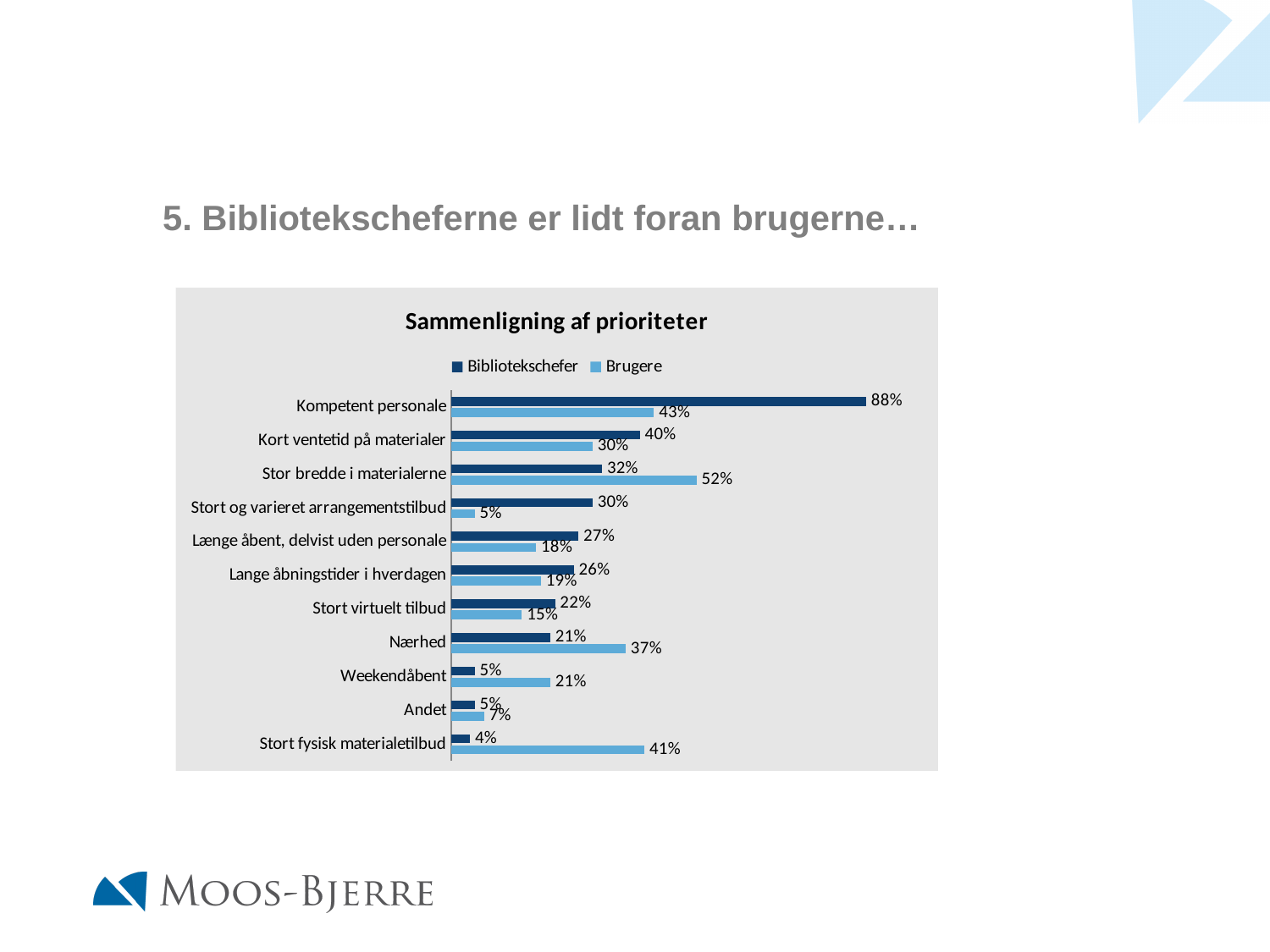
What is the difference between the Bibliotekschefer and Brugere values for Kompetent personale? 45% How many series does the legend list? 2 How many categories are shown in the chart? 11 What is the Brugere value for Stor bredde i materialerne? 52% What is the Bibliotekschefer value for Nærhed? 21% What is the Bibliotekschefer value for Kompetent personale? 88% For Weekendåbent, which series has the larger value, Bibliotekschefer or Brugere? Brugere Which category has the lowest Bibliotekschefer value? Stort fysisk materialetilbud What kind of chart is shown on the slide? Bar chart What is the Brugere value for Stort fysisk materialetilbud? 41% Which category has the highest Brugere value? Stor bredde i materialerne What is the title of the chart? Sammenligning af prioriteter